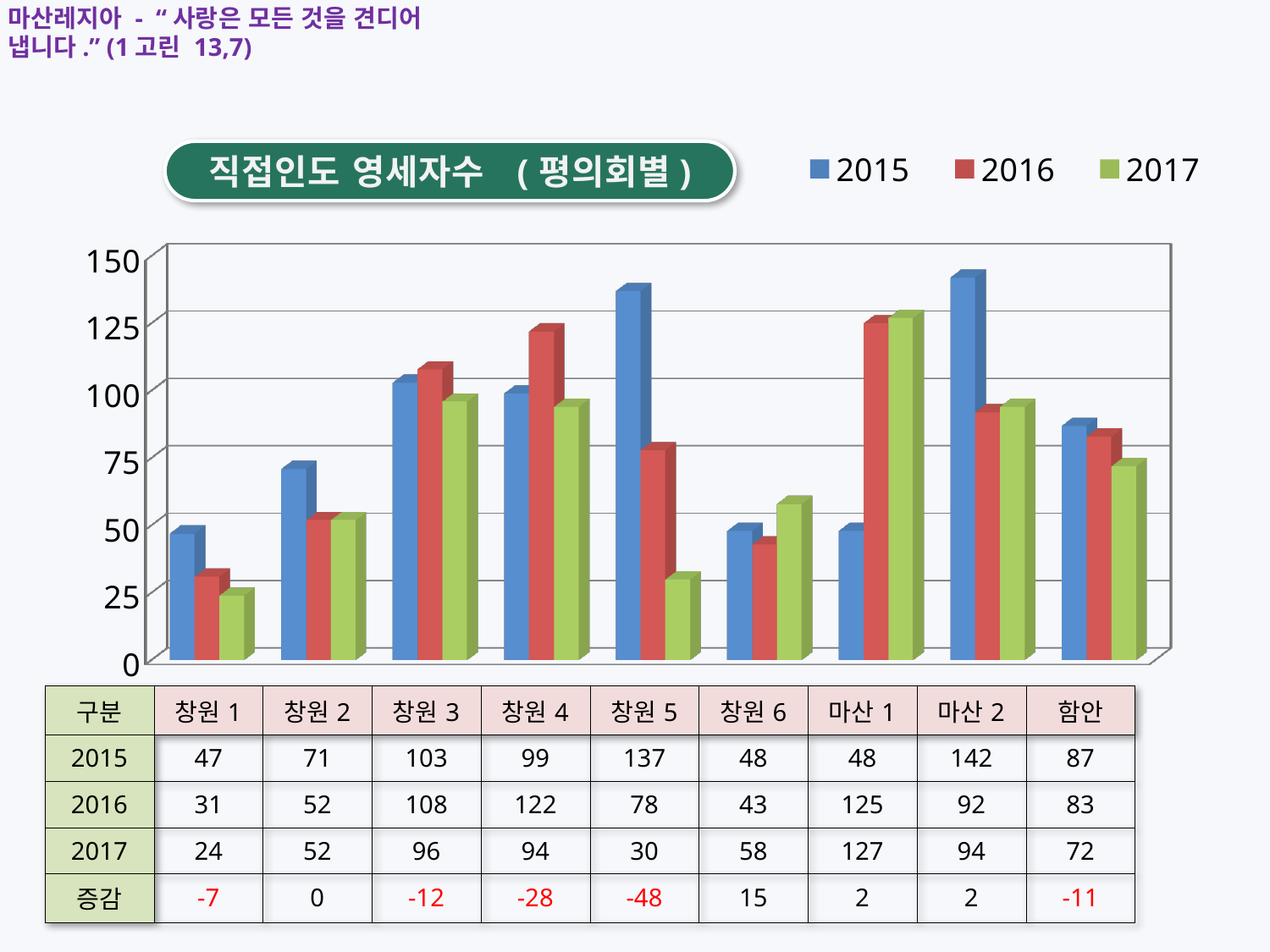
Which category has the lowest 2017 value? 창원 1 How many series does the chart legend list? 3 Which category has the highest 2015 value? 마산 2 Is the 2015 value for 창원 5 greater or less than 125? greater What is the difference between the 2015 and 2017 values for 창원 5? 107 What is the 2016 value for 마산 1? 125 Which series is shown in green in the legend? 2017 What is the 2017 value for 창원 5? 30 How many categories (평의회) are plotted along the x axis? 9 What type of chart is shown on the slide? bar chart Which is larger for 창원 4: the 2016 value or the 2015 value? 2016 What is the 2015 value for 마산 2? 142